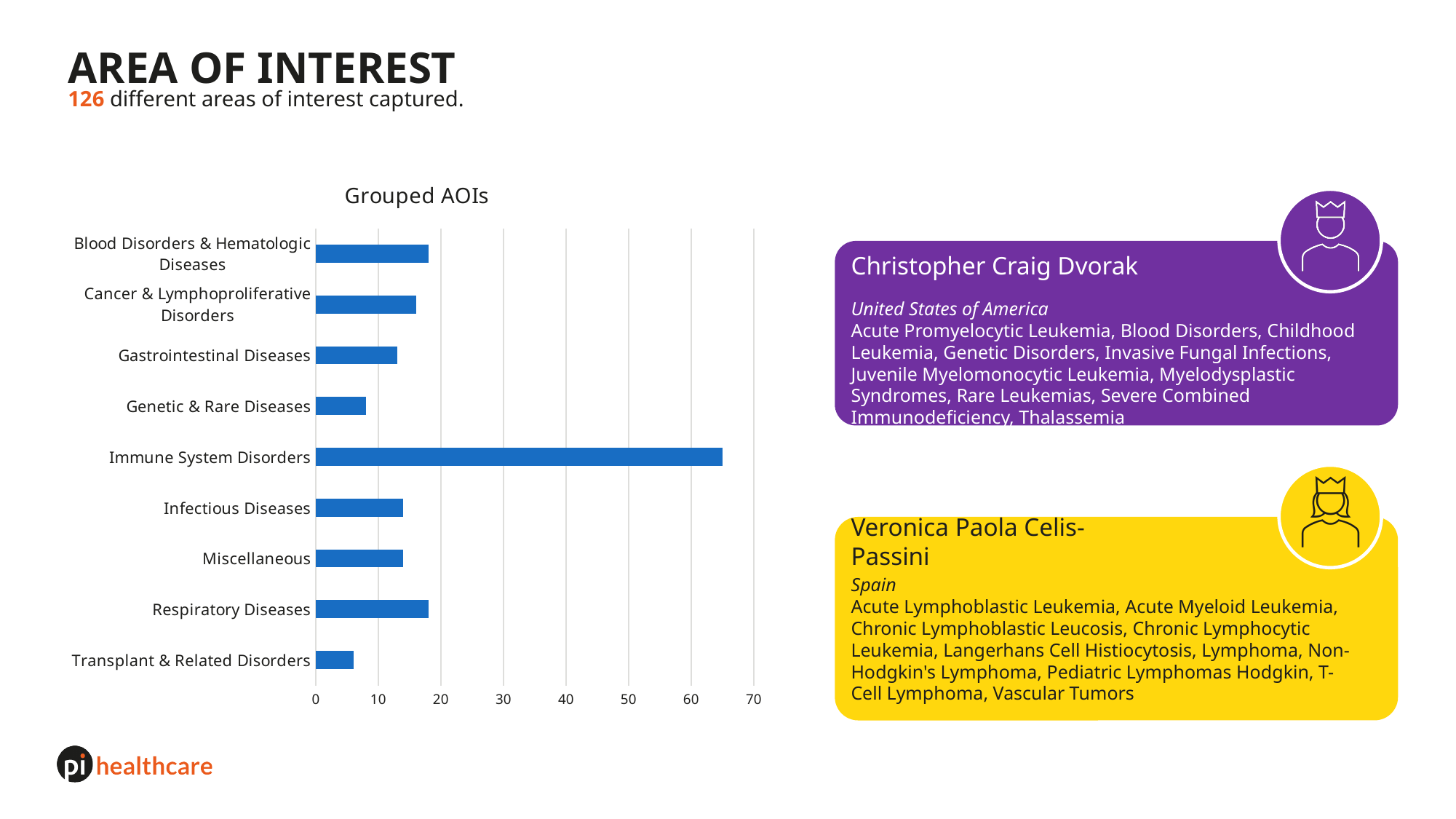
Is the value for Immune System Disorders greater or less than 60? greater Which category has the highest value in the Grouped AOIs chart? Immune System Disorders Is the value for Genetic & Rare Diseases greater or less than 10? less What is the title of the bar chart on the slide? Grouped AOIs What kind of chart is the Grouped AOIs chart? bar chart Which is larger, the value for Cancer & Lymphoproliferative Disorders or the value for Transplant & Related Disorders? Cancer & Lymphoproliferative Disorders Is the value for Transplant & Related Disorders greater or less than 10? less How many categories are shown in the Grouped AOIs chart? 9 Which category has the lowest value in the Grouped AOIs chart? Transplant & Related Disorders Which is larger, the value for Immune System Disorders or the value for Infectious Diseases? Immune System Disorders